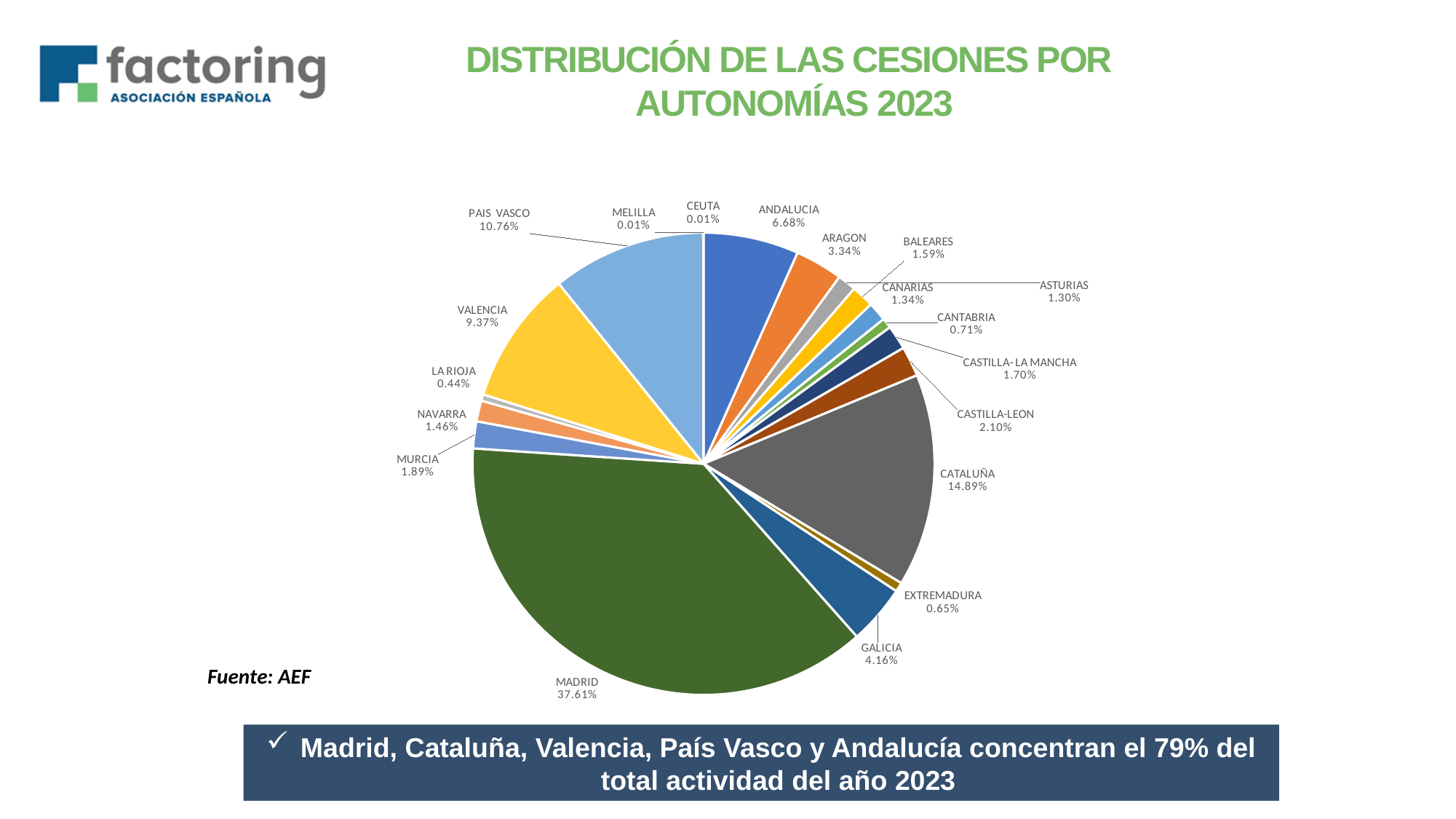
What is the difference in percentage points between PAIS VASCO and VALENCIA? 1.39 How many regions are shown in the pie chart? 19 What percentage is shown for PAIS VASCO? 10.76% What is the difference in percentage points between MADRID and CATALUÑA? 22.72 What is the value for CASTILLA-LA MANCHA? 1.70% What share of the pie does MADRID hold? 37.61% What is the title of the chart? DISTRIBUCIÓN DE LAS CESIONES POR AUTONOMÍAS 2023 Which region has the largest slice of the pie? MADRID Which is larger, the share for GALICIA or the share for ARAGON? GALICIA What type of chart is shown on the slide? Pie chart Which is larger, the share for VALENCIA or the share for PAIS VASCO? PAIS VASCO What is the value shown for CATALUÑA? 14.89%